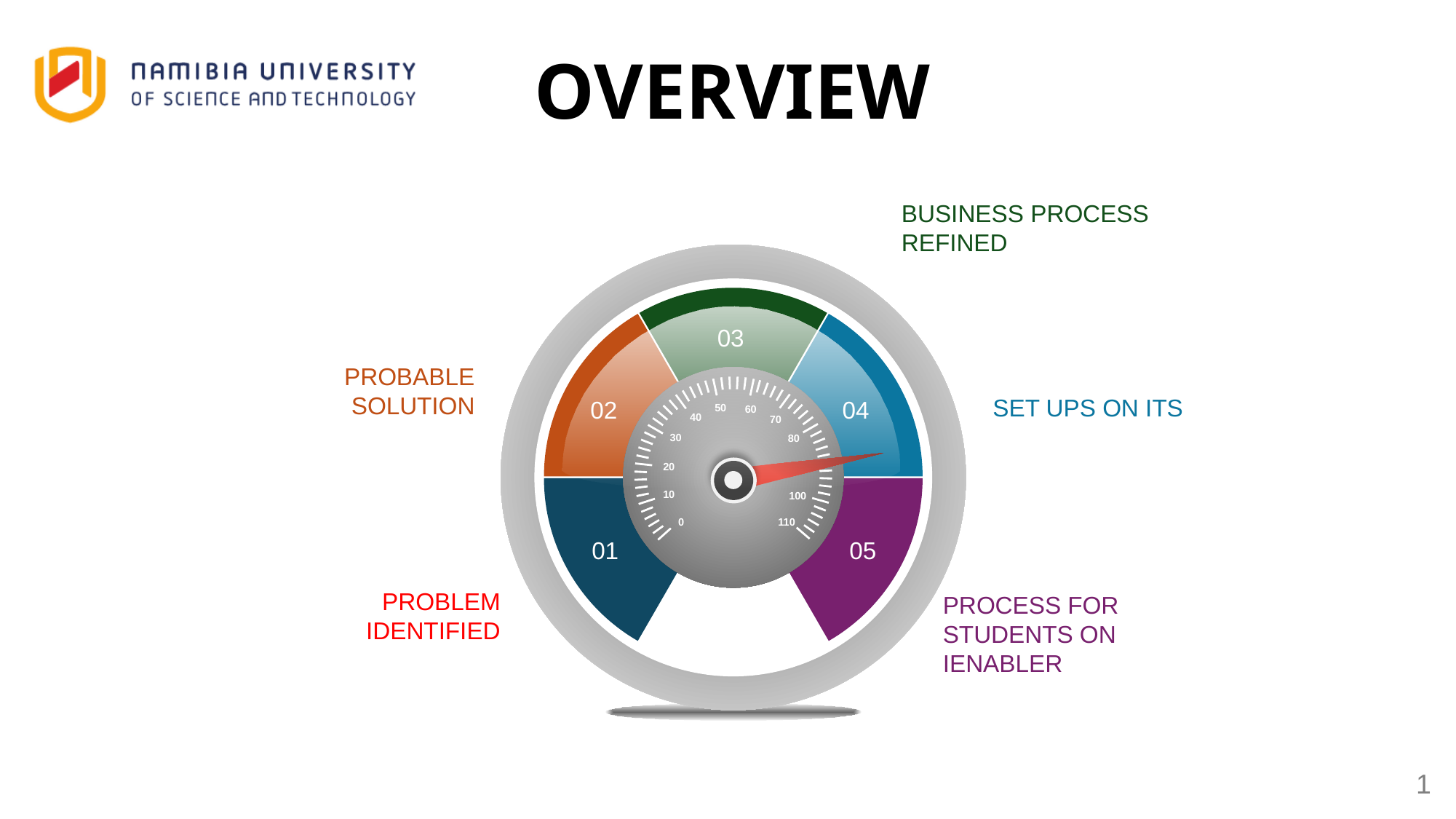
Is the value the gauge needle points to greater or less than 80? greater What colour is segment 02 of the gauge? Orange Which label is attached to segment 03 of the gauge? BUSINESS PROCESS REFINED What is the lowest tick value printed on the gauge scale? 0 What is the highest tick value printed on the gauge scale? 110 Which label is attached to segment 01 of the gauge? PROBLEM IDENTIFIED Is the value the gauge needle points to greater or less than 100? less Which segment number corresponds to "SET UPS ON ITS"? 04 What kind of chart is shown on the slide? Gauge chart What is the title of the slide containing the gauge? OVERVIEW Which segment number corresponds to "PROCESS FOR STUDENTS ON IENABLER"? 05 How many numbered segments does the gauge have? 5